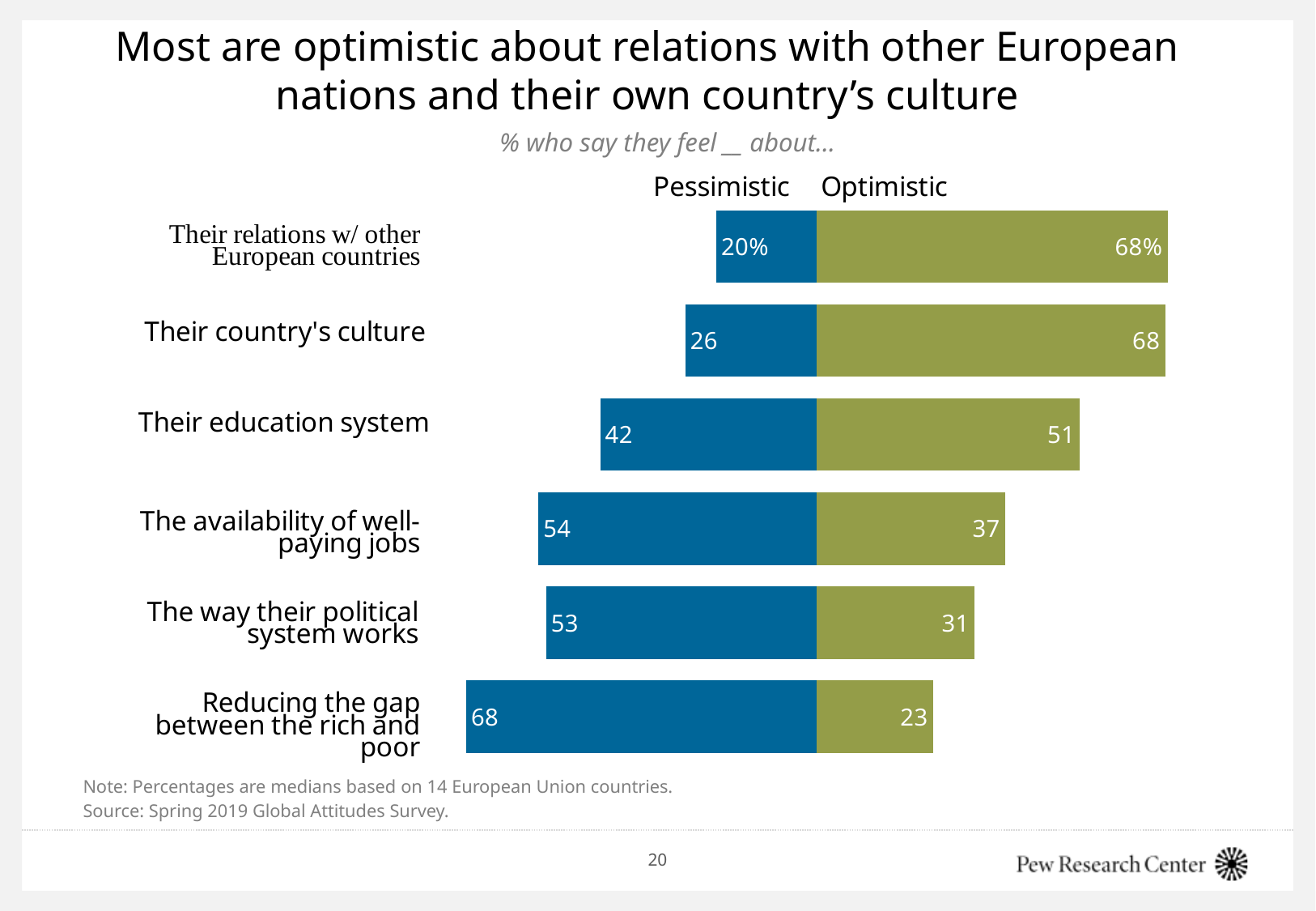
What percentage say they feel pessimistic about their relations with other European countries? 20% What kind of chart is shown on the slide? Bar chart Which colour represents the Optimistic series? Green What percentage say they feel optimistic about their country's culture? 68 Which category has the lowest optimistic percentage? Reducing the gap between the rich and poor What percentage say they feel optimistic about the way their political system works? 31 Which category has the highest pessimistic percentage? Reducing the gap between the rich and poor Is the optimistic percentage for the availability of well-paying jobs larger or smaller than the optimistic percentage for the way their political system works? larger What percentage say they feel pessimistic about the availability of well-paying jobs? 54 How many categories are shown in the chart? 6 What is the difference between the pessimistic and optimistic percentages for their education system? 9 How many series does the chart show? 2